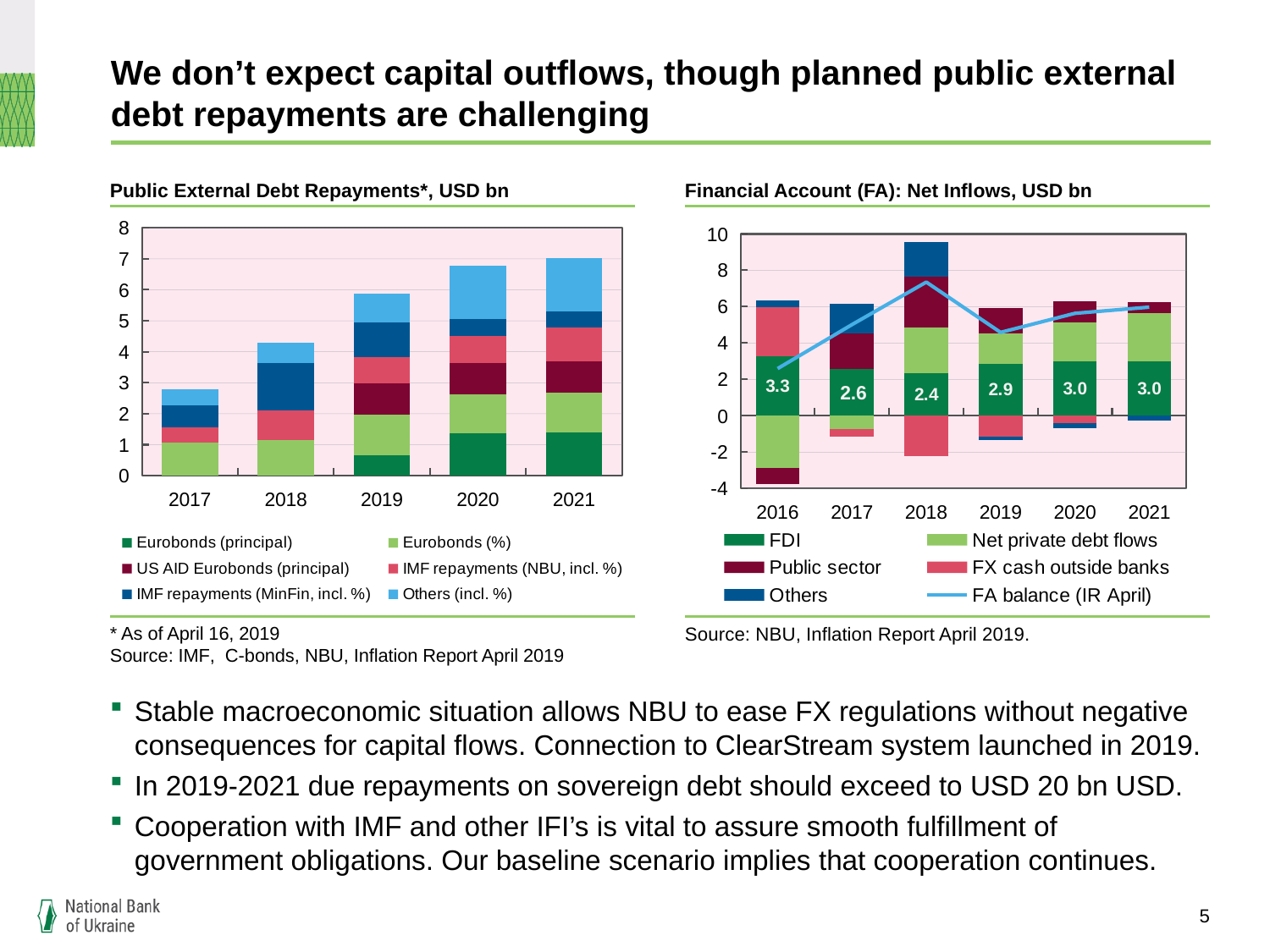
In the 'Financial Account (FA): Net Inflows, USD bn' chart, what is the difference between the FDI values for 2016 and 2018? 0.9 In the 'Financial Account (FA): Net Inflows, USD bn' chart, what is the FDI value for 2018? 2.4 How many series does the legend of the 'Public External Debt Repayments*, USD bn' chart list? 6 In the 'Financial Account (FA): Net Inflows, USD bn' chart, which year has the lowest FDI value? 2018 What kind of chart is the 'Public External Debt Repayments*, USD bn' chart? Stacked bar chart In the 'Public External Debt Repayments*, USD bn' chart, do the total repayments rise or fall from 2017 to 2021? rise In the 'Financial Account (FA): Net Inflows, USD bn' chart, what is the FDI value for 2016? 3.3 In the 'Financial Account (FA): Net Inflows, USD bn' chart, which year has the highest FDI value? 2016 How many entries does the legend of the 'Financial Account (FA): Net Inflows, USD bn' chart list? 6 In the 'Public External Debt Repayments*, USD bn' chart, how many years are shown on the x axis? 5 In the 'Public External Debt Repayments*, USD bn' chart, is the total repayment for 2021 greater or less than 6? greater In the 'Financial Account (FA): Net Inflows, USD bn' chart, is the FDI value larger in 2017 or in 2019? 2019